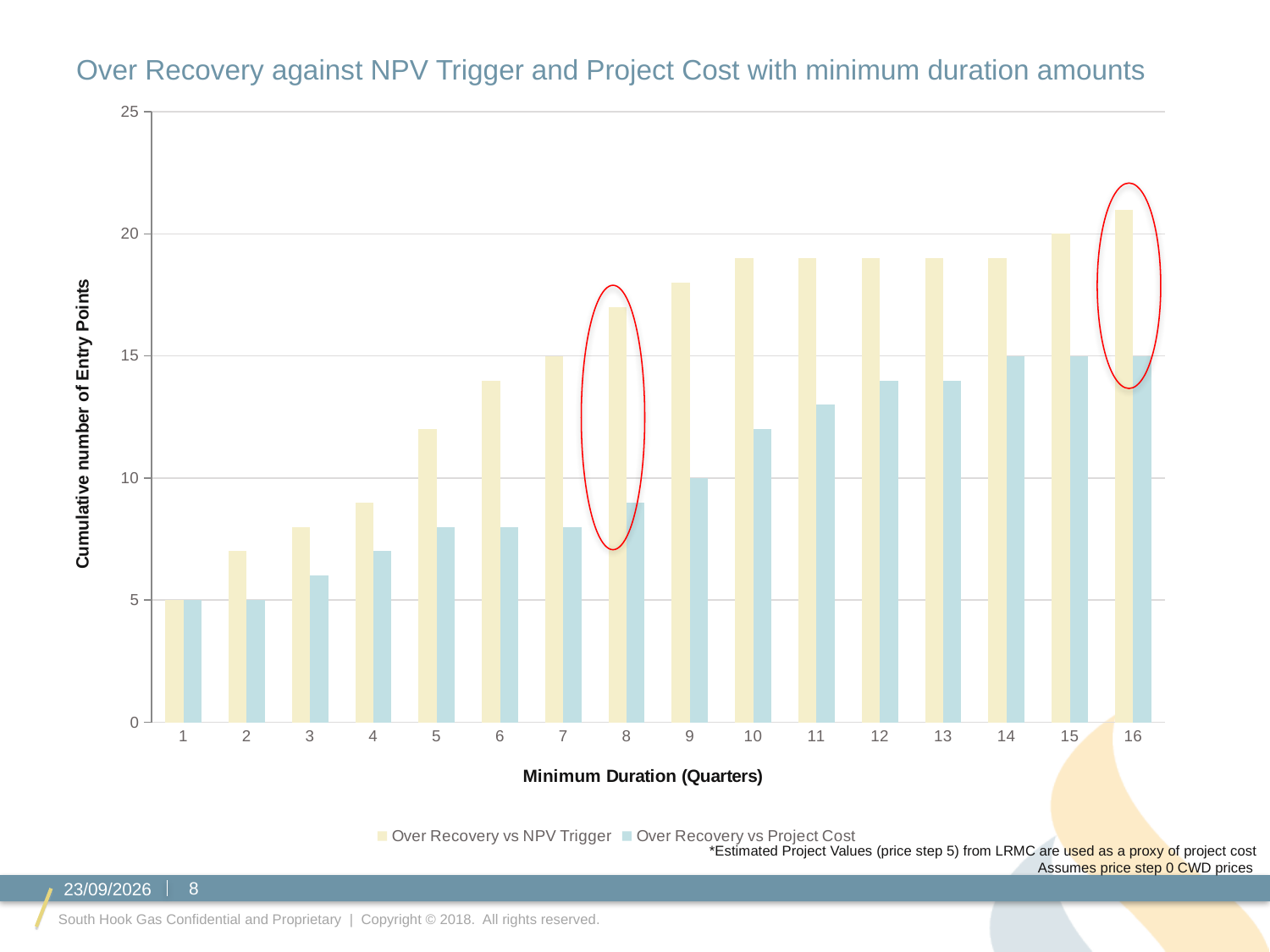
Is the value of Over Recovery vs Project Cost at 8 quarters greater or less than 10? less Which minimum duration has the highest Over Recovery vs NPV Trigger value? 16 How many series does the legend list? 2 What is the value of Over Recovery vs Project Cost at a minimum duration of 9 quarters? 10 Do the Over Recovery vs Project Cost values generally rise or fall as minimum duration increases? Rise How many minimum duration categories are shown on the x axis? 16 Is the value of Over Recovery vs NPV Trigger at 16 quarters greater or less than 20? greater What is the value of Over Recovery vs Project Cost at a minimum duration of 1 quarter? 5 At a minimum duration of 10 quarters, which series has the larger value, Over Recovery vs NPV Trigger or Over Recovery vs Project Cost? Over Recovery vs NPV Trigger What kind of chart is shown on the slide? Bar chart What is the value of Over Recovery vs NPV Trigger at a minimum duration of 15 quarters? 20 What is the value of Over Recovery vs NPV Trigger at a minimum duration of 7 quarters? 15